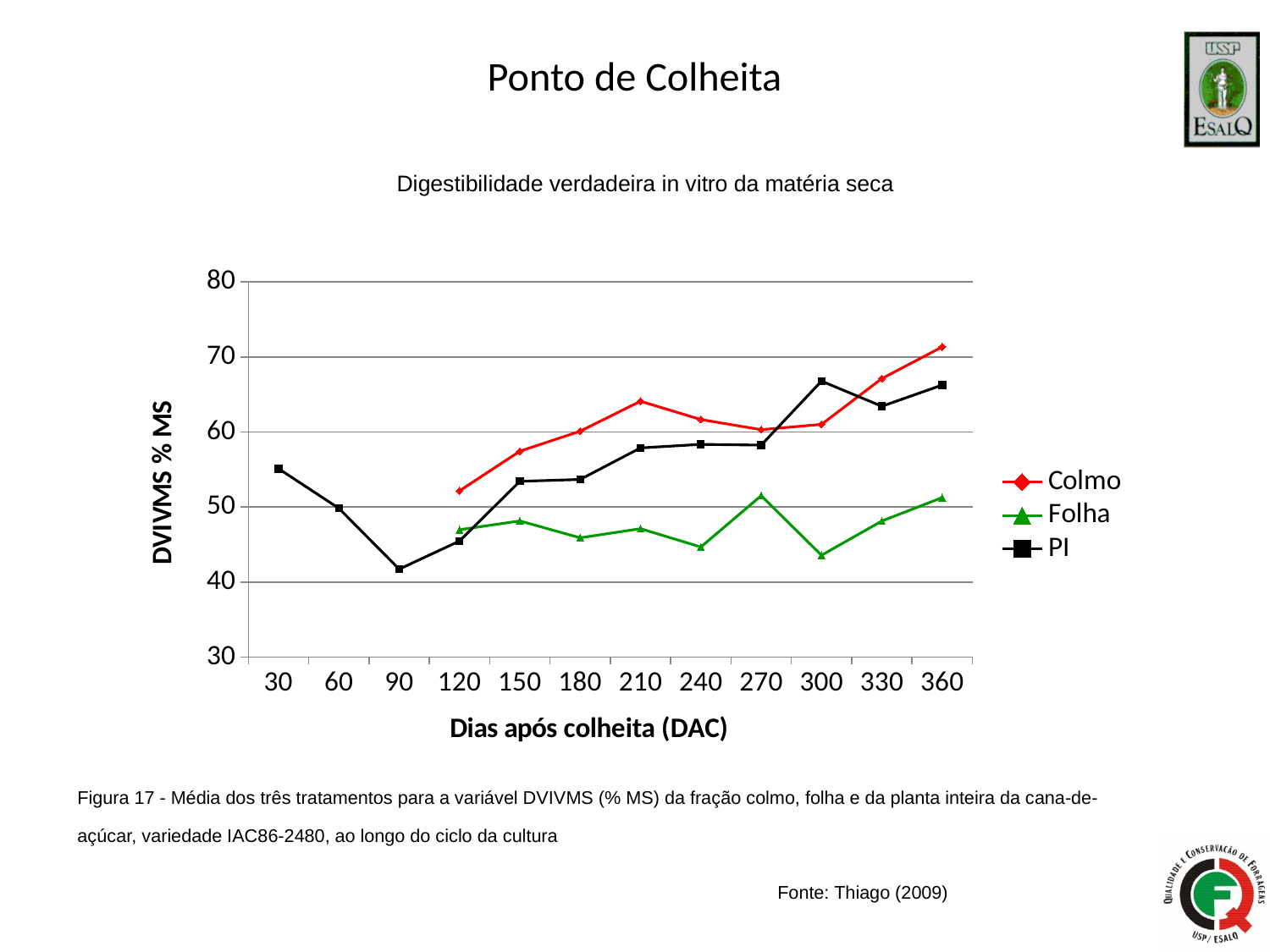
What kind of chart is shown on the slide? line chart Is the value for Folha at 300 DAC greater or less than 50? less Is the value for PI at 90 DAC greater or less than 50? less At 300 DAC, which is higher: PI or Colmo? PI At which DAC does the Colmo series have its lowest value? 120 How many series does the legend list? 3 Which series has the highest value at 360 DAC? Colmo How many DAC points are shown along the x axis? 12 At which DAC does the PI series reach its lowest value? 90 Which series has the lowest value at 360 DAC? Folha Does the Colmo series rise or fall from 300 DAC to 360 DAC? rise Is the value for Colmo at 210 DAC greater or less than 60? greater